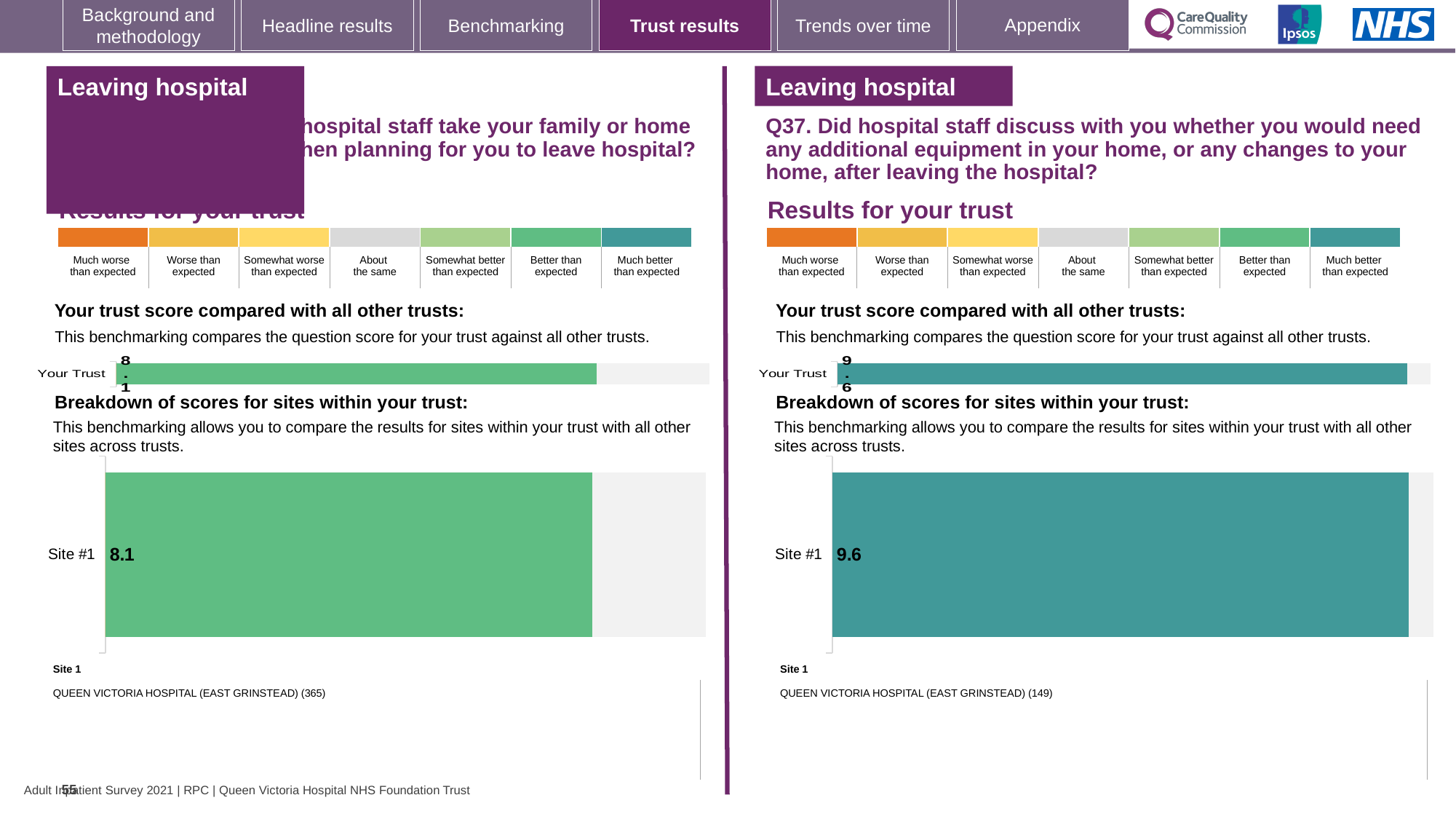
On the right-hand side of the slide (Q37), what is the score shown for Site #1 in the 'Breakdown of scores for sites within your trust' chart? 9.6 What is the difference between the Site #1 score in the right-hand (Q37) breakdown chart and the Site #1 score in the left-hand breakdown chart? 1.5 How many sites are plotted in the left-hand 'Breakdown of scores for sites within your trust' chart? 1 What kind of chart is used to show the Site #1 score on the right-hand side of the slide (Q37)? Bar chart On the left-hand side of the slide, what value is shown for 'Your Trust' in the 'Your trust score compared with all other trusts' chart? 8.1 Which is larger: the Site #1 score in the left-hand breakdown chart or the Site #1 score in the right-hand (Q37) breakdown chart? The right-hand (Q37) chart Which site name is listed as Site 1 in the right-hand (Q37) breakdown chart? QUEEN VICTORIA HOSPITAL (EAST GRINSTEAD) (149) On the right-hand side of the slide (Q37), what value is shown for 'Your Trust' in the 'Your trust score compared with all other trusts' chart? 9.6 Which site name is listed as Site 1 in the left-hand breakdown chart? QUEEN VICTORIA HOSPITAL (EAST GRINSTEAD) (365) How many sites are plotted in the right-hand (Q37) 'Breakdown of scores for sites within your trust' chart? 1 Is the Site #1 score in the left-hand breakdown chart greater or less than the Site #1 score in the right-hand (Q37) breakdown chart? less On the left-hand side of the slide, what is the score shown for Site #1 in the 'Breakdown of scores for sites within your trust' chart? 8.1